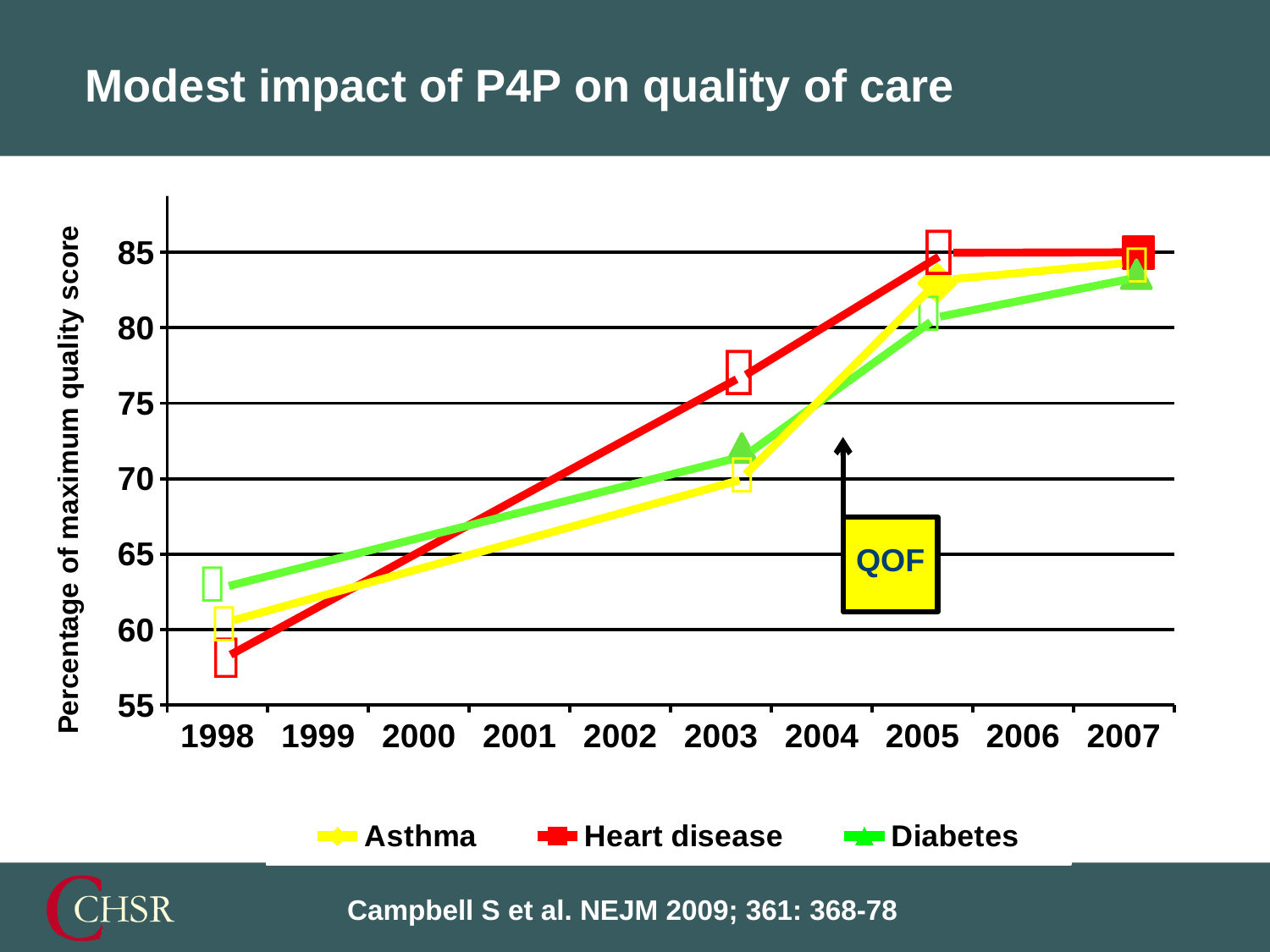
In 1998, which is larger: the value for Diabetes or the value for Heart disease? Diabetes Is the value for Heart disease in 1998 greater or less than 60? less Which series is highest in 2003? Heart disease How many series does the legend list? 3 Is the value for Asthma in 2005 greater or less than 80? greater What is the label on the vertical axis? Percentage of maximum quality score What kind of chart is shown on the slide? line chart Is the value for Heart disease in 2003 greater or less than 75? greater Do the values for Asthma rise or fall from 1998 to 2007? rise Which series is lowest in 1998? Heart disease In 2005, which is larger: the value for Heart disease or the value for Diabetes? Heart disease